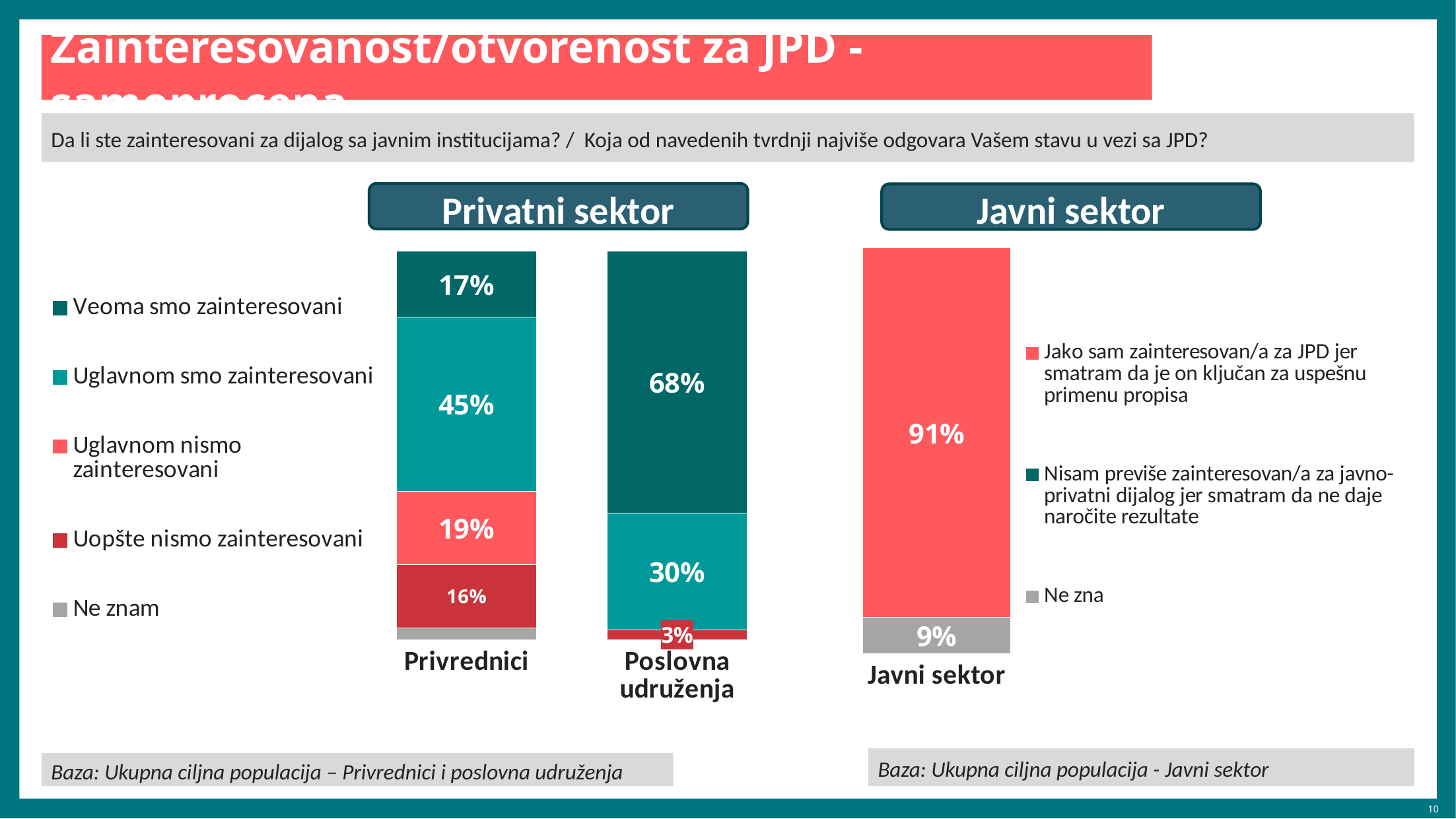
In the Privatni sektor chart, what percentage of Poslovna udruženja answered "Uglavnom smo zainteresovani"? 30% In the Javni sektor chart, what percentage answered that they are very interested in JPD ("Jako sam zainteresovan/a za JPD...")? 91% In the Privatni sektor chart, what percentage of Privrednici answered "Uglavnom smo zainteresovani"? 45% In the Privatni sektor chart, what is the difference between the "Uglavnom smo zainteresovani" shares of Privrednici and Poslovna udruženja? 15% In the Javni sektor chart, what percentage answered "Ne zna"? 9% In the Privatni sektor chart, what is the difference between the "Veoma smo zainteresovani" shares of Poslovna udruženja and Privrednici? 51% In the Privatni sektor chart, what percentage of Poslovna udruženja answered "Veoma smo zainteresovani"? 68% How many entries does the legend of the Privatni sektor chart list? 5 What type of chart is used for the Javni sektor data? Stacked bar chart In the Privatni sektor chart, what percentage of Privrednici answered "Veoma smo zainteresovani"? 17% In the Privatni sektor chart, what percentage of Privrednici answered "Uopšte nismo zainteresovani"? 16% In the Privatni sektor chart, which group has the larger share of "Veoma smo zainteresovani": Privrednici or Poslovna udruženja? Poslovna udruženja